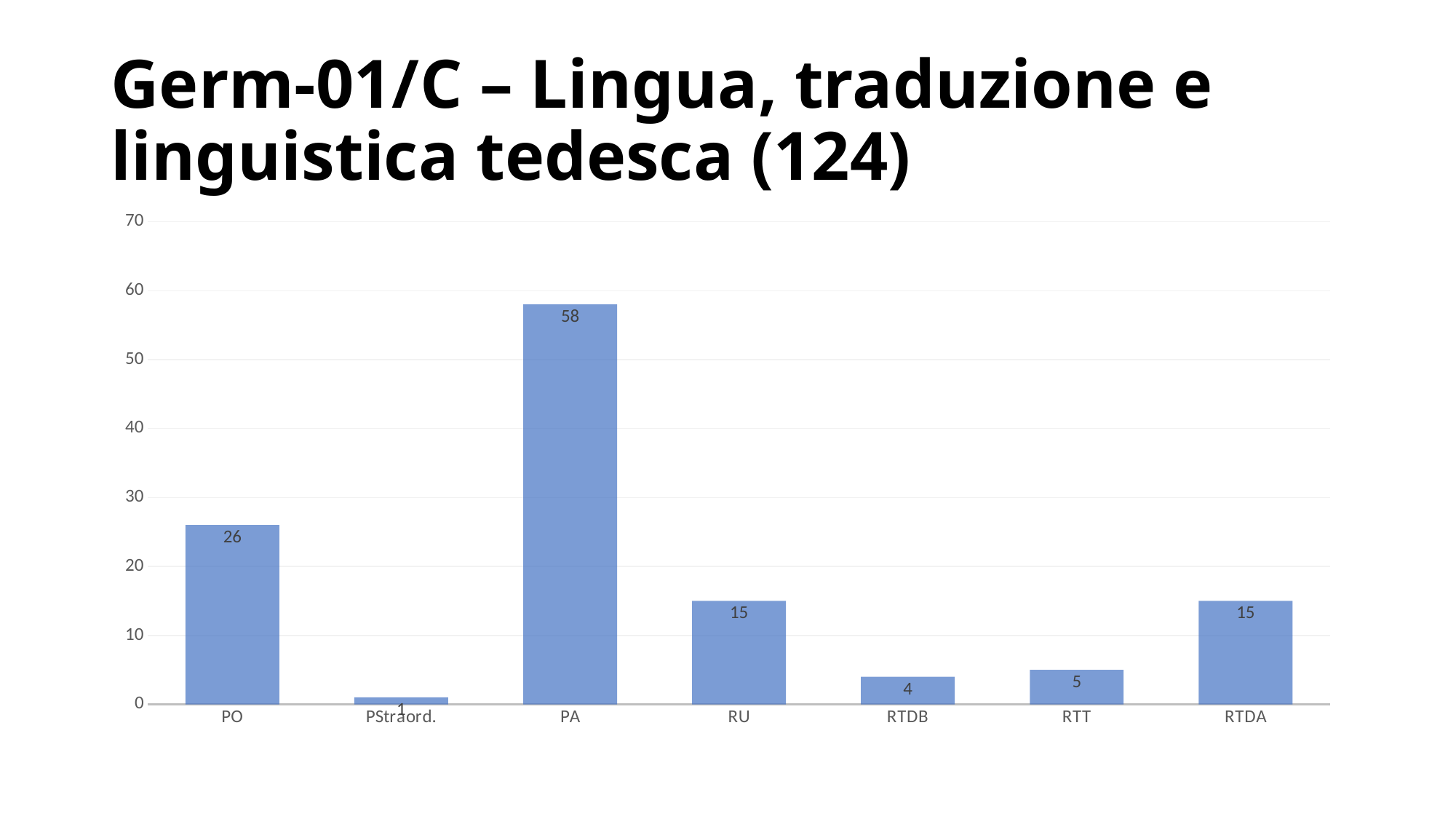
What is the value for RTT? 5 What is the difference between the values for PA and PO? 32 What is the value for PO? 26 Is the value for PA greater or less than 50? greater Which is larger, the value for RU or the value for RTT? RU How many categories are shown on the x axis? 7 What is the value for RTDB? 4 What kind of chart is shown on the slide? bar chart What is the value for PA? 58 Which category has the highest value? PA What is the title of the slide? Germ-01/C – Lingua, traduzione e linguistica tedesca (124) Which category has the lowest value? PStraord.